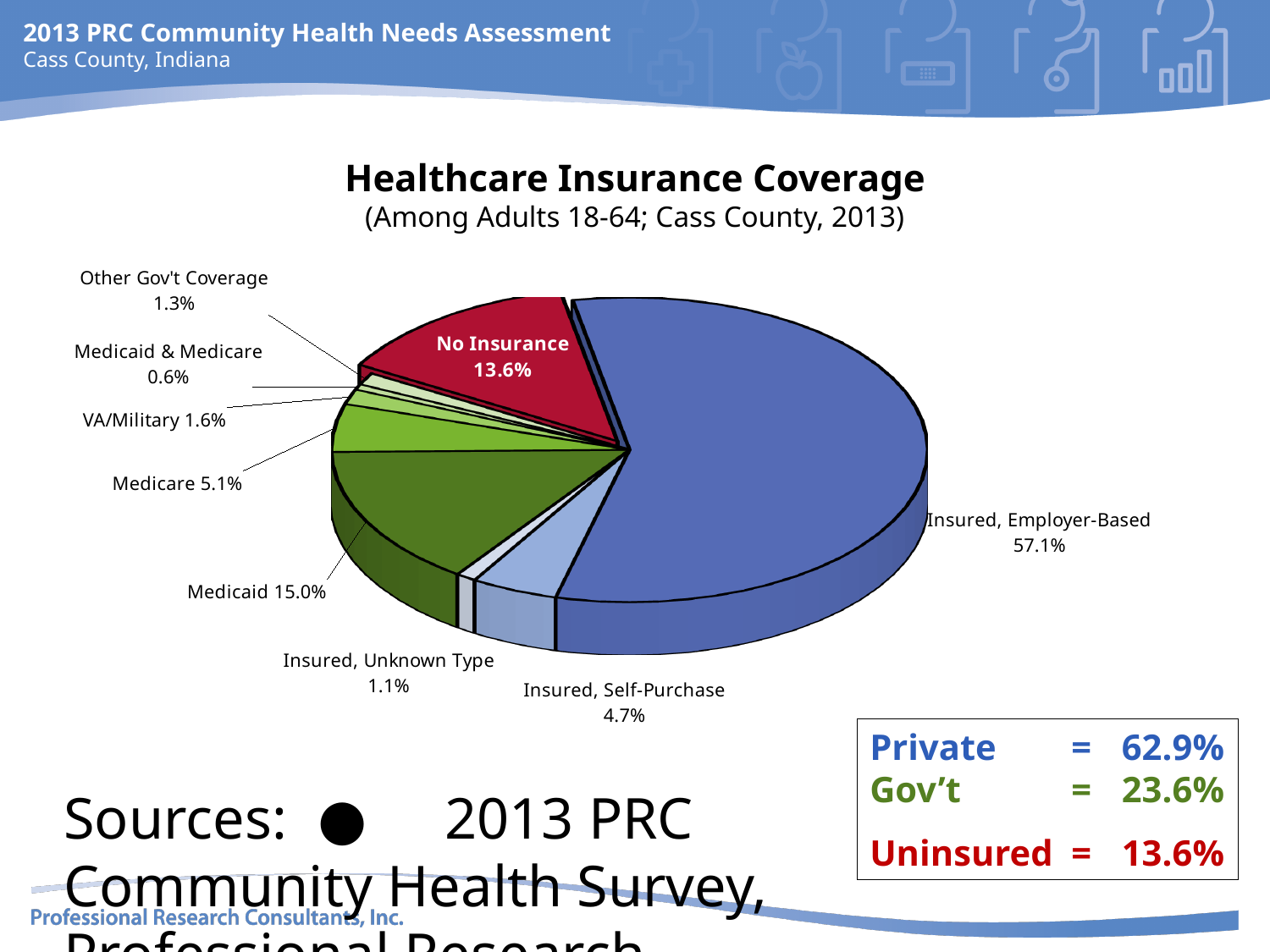
Which is larger, the share for Insured, Self-Purchase or the share for Medicare? Medicare What is the value shown for VA/Military? 1.6% What is the value shown for Medicaid? 15.0% What is the difference between the Medicaid share and the No Insurance share? 1.4% Which category has the largest share of the pie? Insured, Employer-Based What percentage of adults 18-64 have no insurance? 13.6% What is the title of the chart? Healthcare Insurance Coverage Which category has the smallest share of the pie? Medicaid & Medicare What percentage of adults 18-64 have employer-based insurance? 57.1% How many slices does the pie chart have? 9 What is the value shown for Medicare? 5.1% What type of chart is shown on the slide? Pie chart